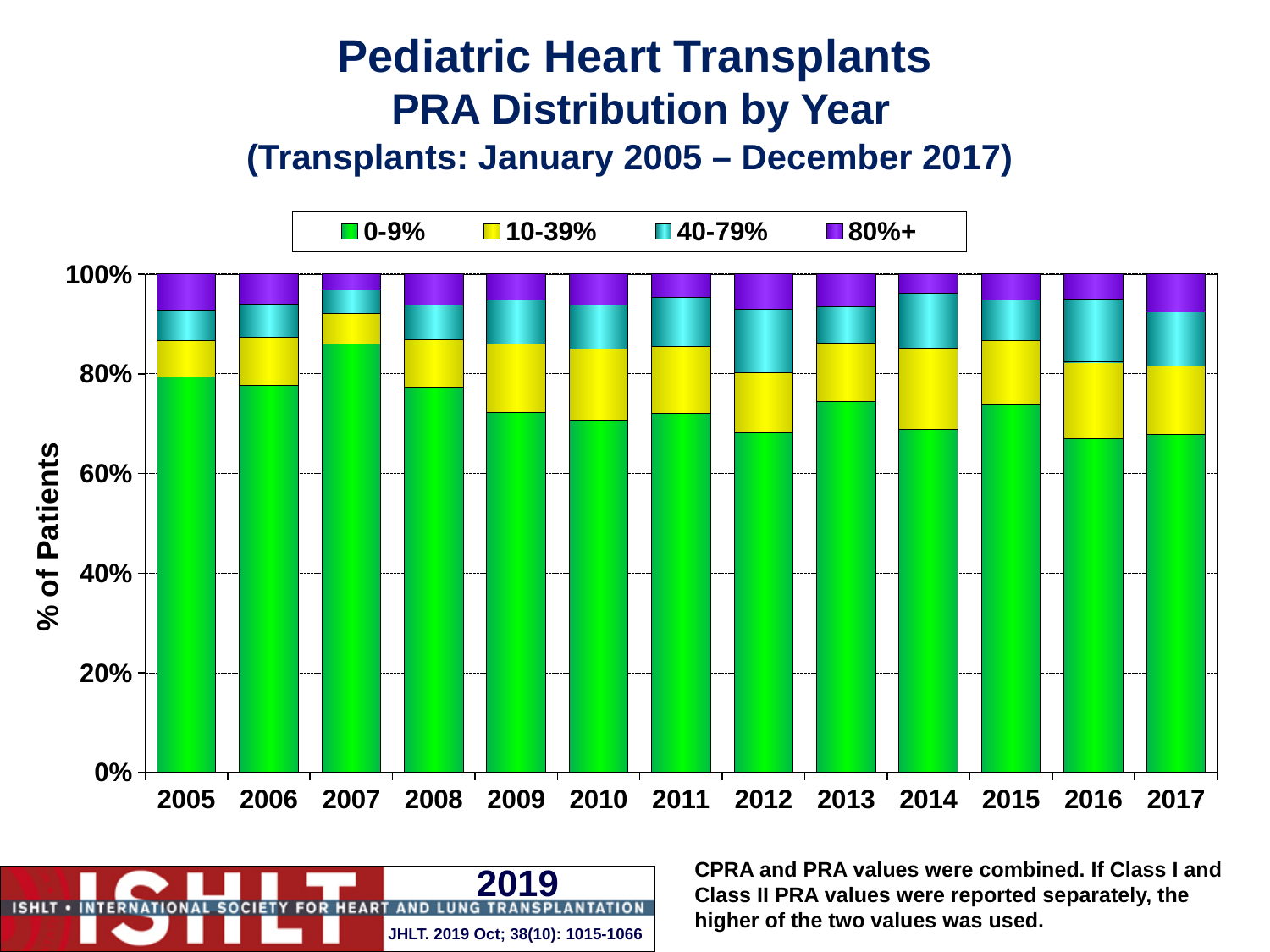
Which year has the larger 0-9% PRA share, 2005 or 2009? 2005 How many years are shown along the x axis of the chart? 13 Overall, does the 0-9% PRA share rise or fall from 2005 to 2017? fall Is the 0-9% PRA share for 2016 greater or less than 80%? less Is the 0-9% PRA share for 2012 greater or less than 60%? greater What kind of chart is shown on the slide? Stacked bar chart What is the label on the y axis of the chart? % of Patients Which colour represents the 80%+ PRA category in the legend? Purple Which year has the largest 0-9% PRA share? 2007 What does each stacked bar total? 100% How many PRA categories does the legend list? 4 Is the 0-9% PRA share for 2007 greater or less than 80%? greater